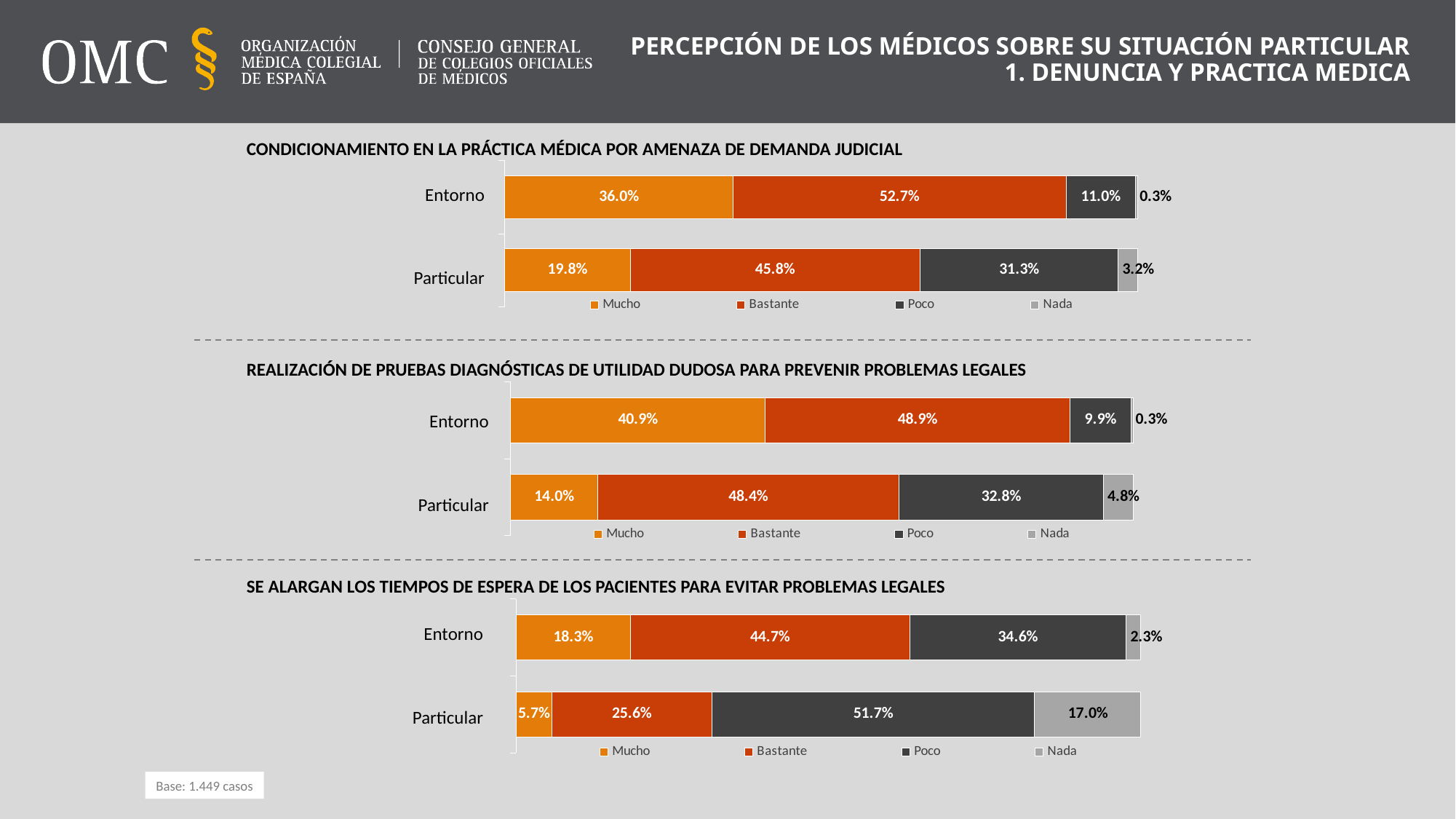
In the chart titled 'SE ALARGAN LOS TIEMPOS DE ESPERA DE LOS PACIENTES PARA EVITAR PROBLEMAS LEGALES', which segment is smallest for Particular? Mucho How many series does the legend of the chart titled 'CONDICIONAMIENTO EN LA PRÁCTICA MÉDICA POR AMENAZA DE DEMANDA JUDICIAL' list? 4 In the chart titled 'REALIZACIÓN DE PRUEBAS DIAGNÓSTICAS DE UTILIDAD DUDOSA PARA PREVENIR PROBLEMAS LEGALES', which is larger: the 'Poco' value for Entorno or for Particular? Particular In the chart titled 'SE ALARGAN LOS TIEMPOS DE ESPERA DE LOS PACIENTES PARA EVITAR PROBLEMAS LEGALES', what is the 'Poco' value for Particular? 51.7% In the chart titled 'SE ALARGAN LOS TIEMPOS DE ESPERA DE LOS PACIENTES PARA EVITAR PROBLEMAS LEGALES', what is the total of the Particular bar? 100.0% In the chart titled 'SE ALARGAN LOS TIEMPOS DE ESPERA DE LOS PACIENTES PARA EVITAR PROBLEMAS LEGALES', what is the difference between the 'Nada' values for Particular and Entorno? 14.7 percentage points In the chart titled 'CONDICIONAMIENTO EN LA PRÁCTICA MÉDICA POR AMENAZA DE DEMANDA JUDICIAL', what is the 'Nada' value for Particular? 3.2% In the chart titled 'CONDICIONAMIENTO EN LA PRÁCTICA MÉDICA POR AMENAZA DE DEMANDA JUDICIAL', what is the difference between the 'Mucho' values for Entorno and Particular? 16.2 percentage points In the chart titled 'CONDICIONAMIENTO EN LA PRÁCTICA MÉDICA POR AMENAZA DE DEMANDA JUDICIAL', what is the 'Bastante' value for Entorno? 52.7% In the chart titled 'REALIZACIÓN DE PRUEBAS DIAGNÓSTICAS DE UTILIDAD DUDOSA PARA PREVENIR PROBLEMAS LEGALES', which segment is largest for Particular? Bastante In the chart titled 'REALIZACIÓN DE PRUEBAS DIAGNÓSTICAS DE UTILIDAD DUDOSA PARA PREVENIR PROBLEMAS LEGALES', what is the 'Mucho' value for Entorno? 40.9% What kind of chart is the chart titled 'SE ALARGAN LOS TIEMPOS DE ESPERA DE LOS PACIENTES PARA EVITAR PROBLEMAS LEGALES'? Stacked bar chart